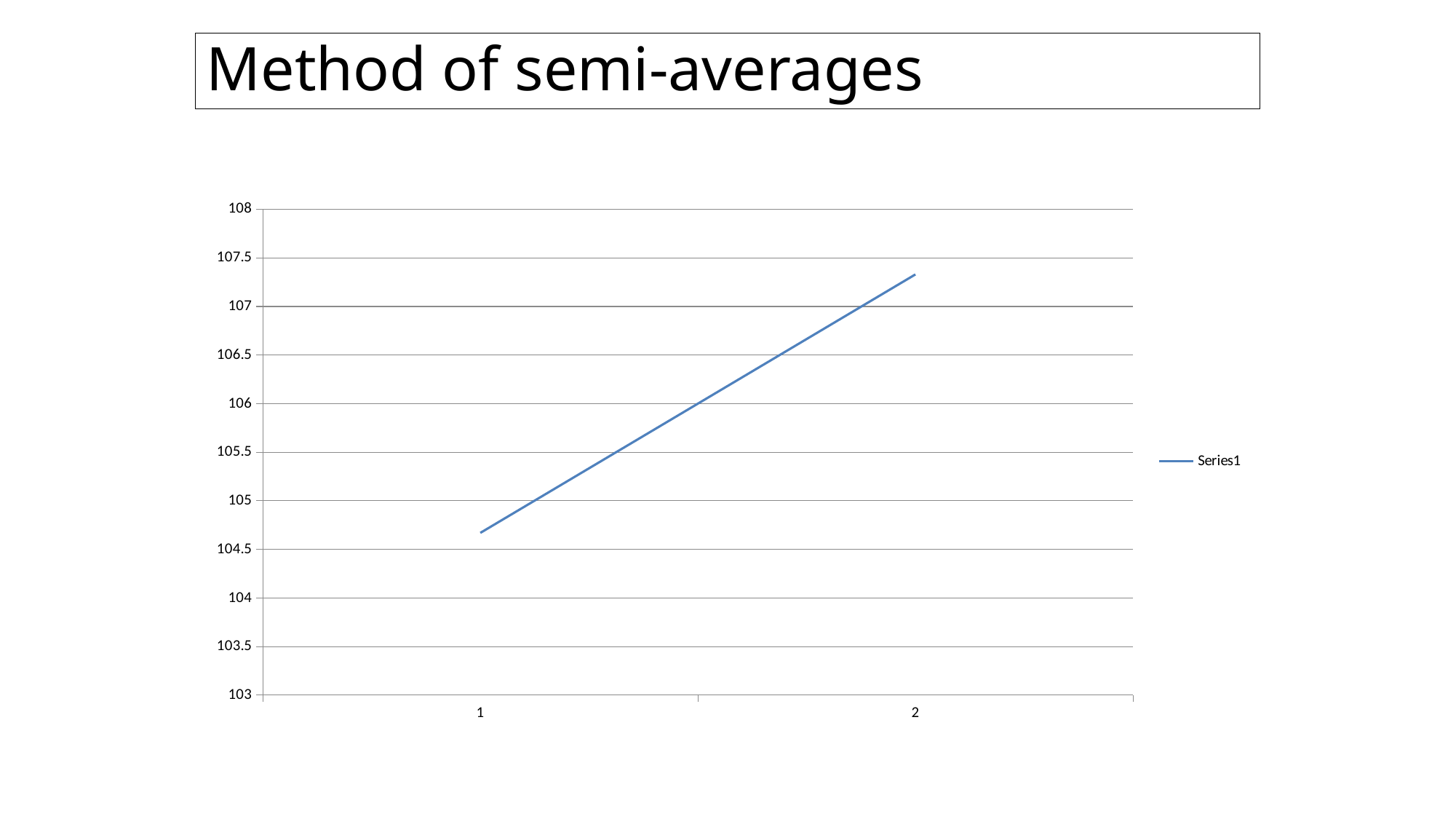
How many series does the legend list? 1 Is the value at point 1 greater or less than 105? less What is the name of the series shown in the legend? Series1 Is the value at point 2 greater or less than 107? greater Which point has the higher value, 1 or 2? 2 Which x-axis point has the lowest value? 1 How many data points are plotted on the line? 2 Is the value at point 1 greater or less than 104.5? greater Which x-axis point has the highest value? 2 What kind of chart is shown on the slide? line chart Does the line rise or fall from point 1 to point 2? rises